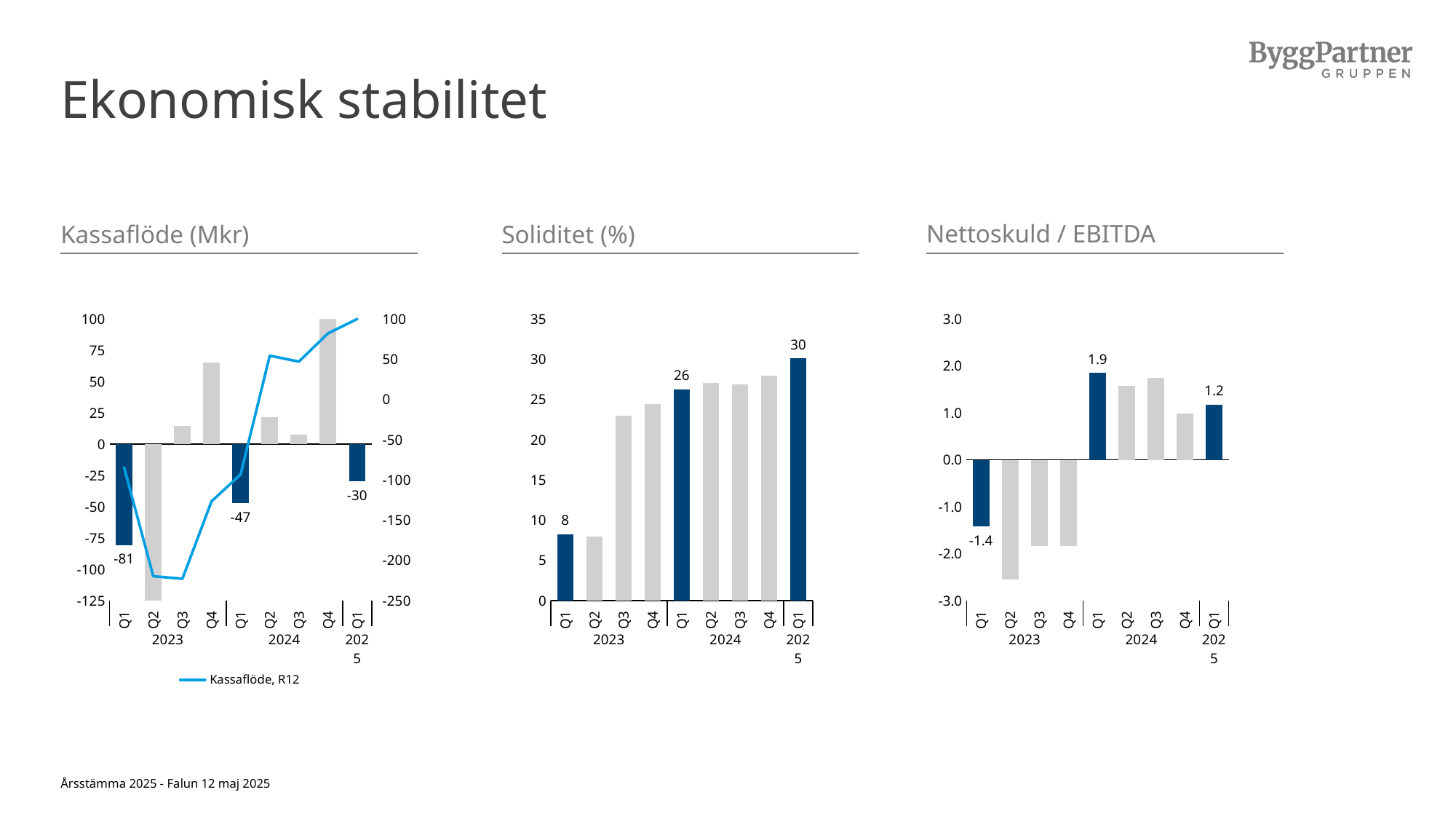
In the Kassaflöde (Mkr) chart, what is the value of the bar for Q1 2025? -30 In the Soliditet (%) chart, do the values generally rise or fall from Q1 2023 to Q1 2025? rise In the Kassaflöde (Mkr) chart, which bar is higher, Q1 2024 or Q1 2025? Q1 2025 In the Kassaflöde (Mkr) chart, what entry does the legend list? Kassaflöde, R12 In the Soliditet (%) chart, how many bars are plotted? 9 In the Kassaflöde (Mkr) chart, what is the value of the bar for Q1 2023? -81 In the Nettoskuld / EBITDA chart, what is the difference between the Q1 2024 value and the Q1 2025 value? 0.7 In the Soliditet (%) chart, is the value for Q3 2023 greater or less than 20? greater In the Soliditet (%) chart, what is the value for Q1 2024? 26 In the Nettoskuld / EBITDA chart, what is the value for Q1 2023? -1.4 In the Soliditet (%) chart, which quarter has the highest value? Q1 2025 In the Soliditet (%) chart, what is the difference between the Q1 2025 value and the Q1 2023 value? 22